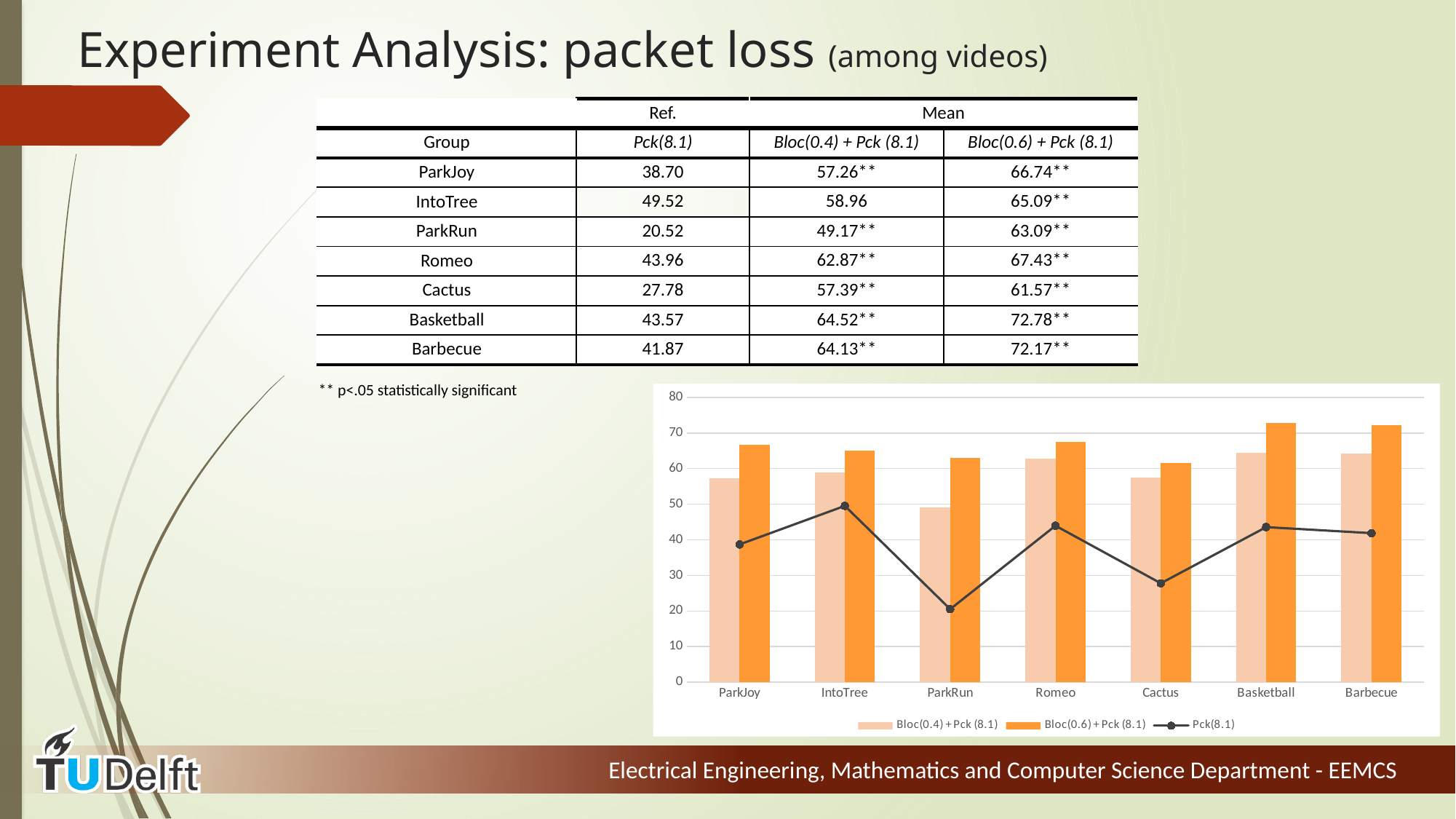
Does the Pck(8.1) line rise or fall from Cactus to Basketball? rise Which is larger, the Bloc(0.4) + Pck (8.1) value for Romeo or for Cactus? Romeo What kind of chart is shown on the slide? Combined bar and line chart How many series does the chart legend list? 3 Is the Pck(8.1) value for ParkRun greater or less than 30? less Is the Bloc(0.6) + Pck (8.1) value for Basketball greater or less than 70? greater Which group has the lowest Bloc(0.4) + Pck (8.1) bar in the chart? ParkRun Which group has the highest Pck(8.1) value in the chart? IntoTree What is the Bloc(0.6) + Pck (8.1) value for ParkJoy, as printed in the table? 66.74 Which group has the lowest Pck(8.1) value in the chart? ParkRun How many video groups are plotted along the x axis of the chart? 7 What is the difference between the Bloc(0.6) + Pck (8.1) and Bloc(0.4) + Pck (8.1) values for ParkJoy, using the table values? 9.48